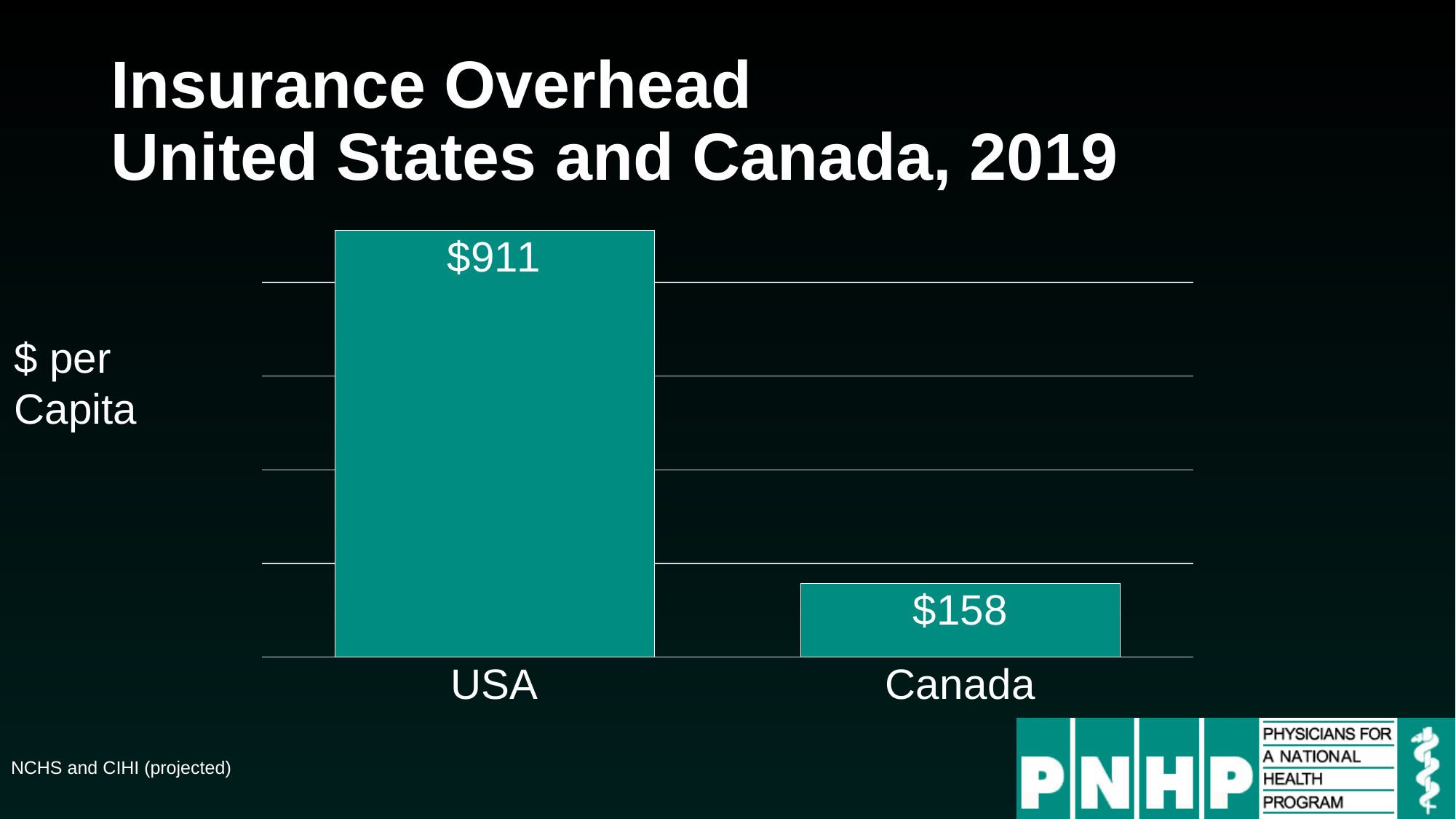
Which country has the lower insurance overhead per capita? Canada What is the title of the chart? Insurance Overhead United States and Canada, 2019 What kind of chart is shown on the slide? bar chart Is the value for the USA larger or smaller than the value for Canada? larger What unit is shown on the vertical axis label? $ per Capita What is the insurance overhead per capita for Canada? $158 What is the difference between the USA and Canada insurance overhead per capita? $753 What is the insurance overhead per capita for the USA? $911 Which country has the higher insurance overhead per capita? USA How many countries are shown in the chart? 2